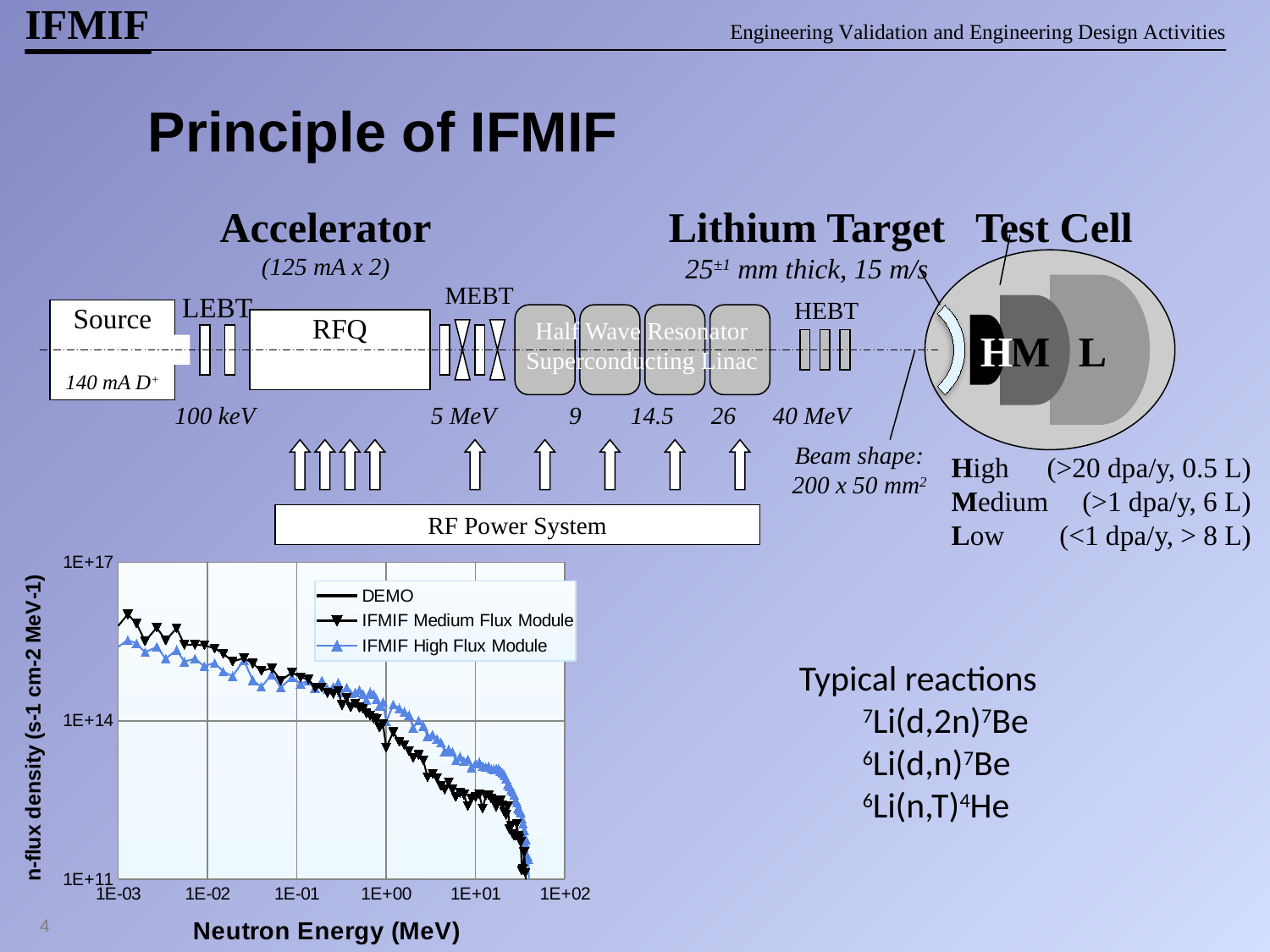
In the neutron flux chart, do the n-flux density values rise or fall as neutron energy increases along the x axis? fall In the neutron flux chart, which series has the higher n-flux density at 1E+01 MeV, IFMIF High Flux Module or IFMIF Medium Flux Module? IFMIF High Flux Module What is the y-axis title of the neutron flux chart? n-flux density (s-1 cm-2 MeV-1) What kind of chart is shown at the bottom left of the slide? line chart What is the highest tick value shown on the y axis of the neutron flux chart? 1E+17 In the neutron flux chart, is the n-flux density of the IFMIF Medium Flux Module at 1E+01 MeV greater or less than 1E+14? less What is the x-axis title of the neutron flux chart? Neutron Energy (MeV) How many series does the legend of the neutron flux chart list? 3 In the neutron flux chart, is the n-flux density of the IFMIF High Flux Module at 1E-03 MeV greater or less than 1E+14? greater